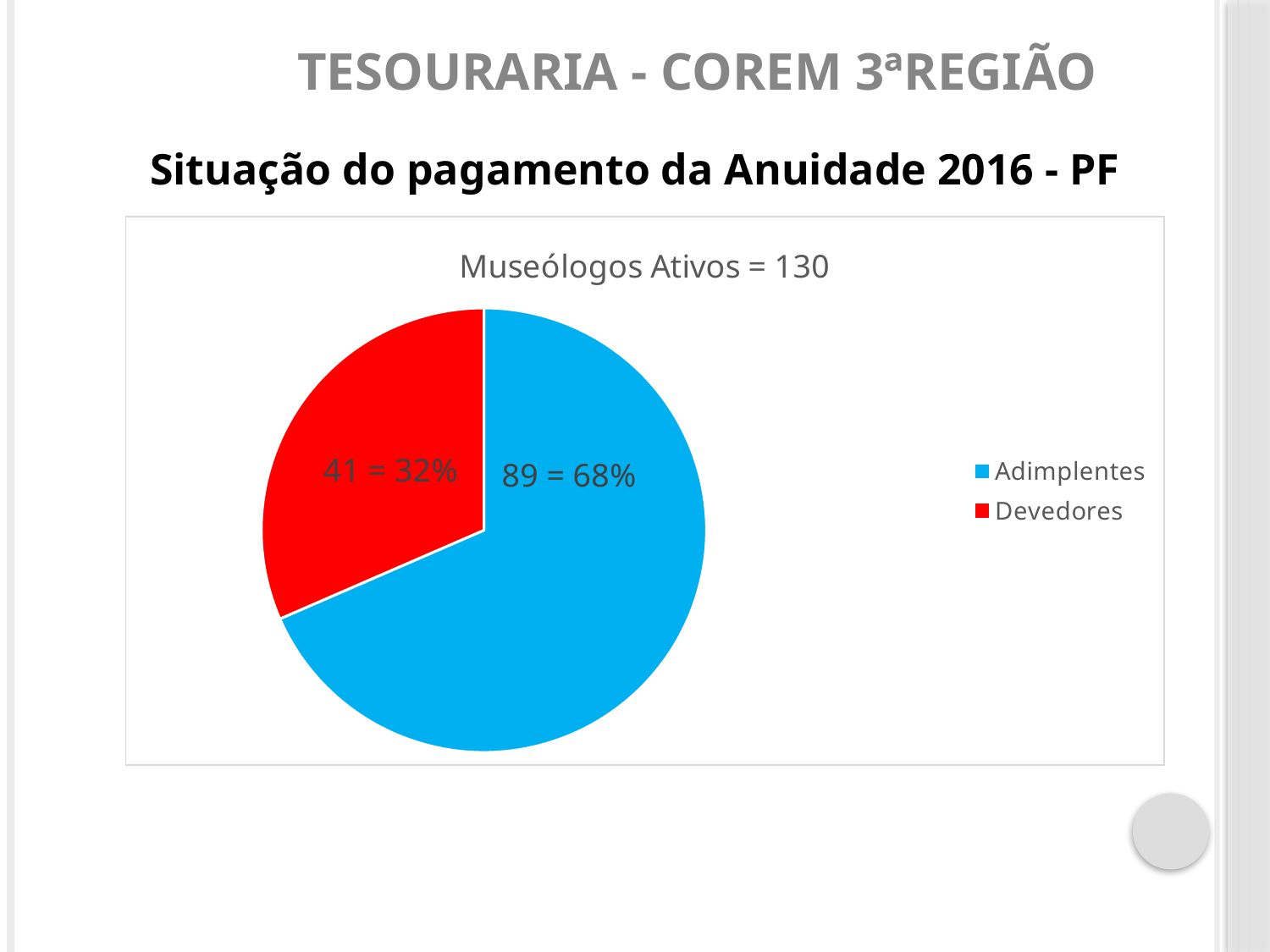
How many entries does the legend list? 2 What share of the pie does Devedores represent? 32% What is the value shown for Devedores? 41 What is the value shown for Adimplentes? 89 What share of the pie does Adimplentes represent? 68% Which category has the largest slice? Adimplentes How many slices does the pie chart have? 2 What is the difference between the Adimplentes and Devedores values? 48 Which category has the smallest slice? Devedores Which colour represents Devedores in the pie chart? red What is the chart's title? Museólogos Ativos = 130 What kind of chart is shown on the slide? pie chart